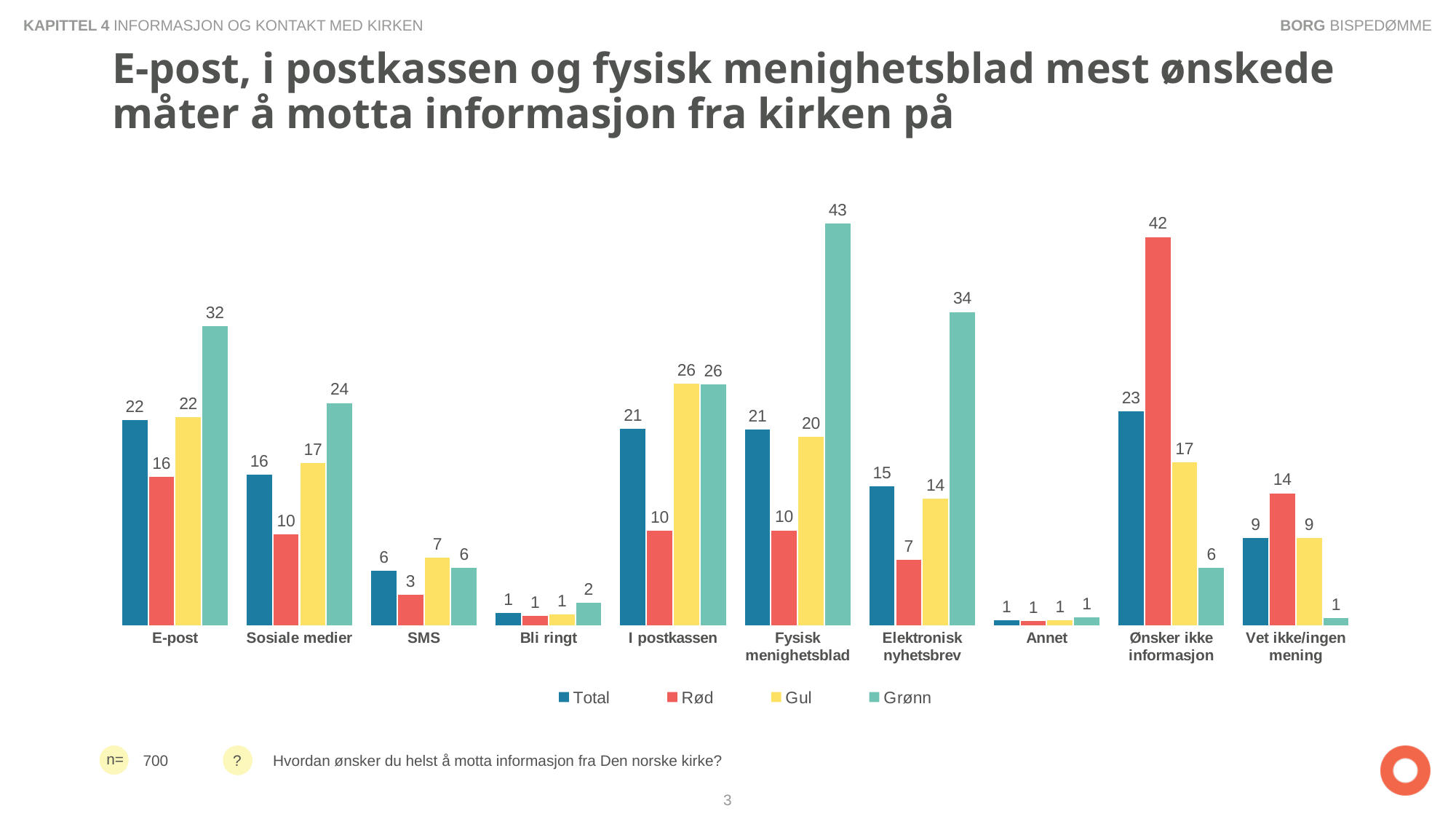
What is the Total value for E-post? 22 How many categories are shown on the x axis? 10 Which category has the highest Total value? Ønsker ikke informasjon Which is larger for Sosiale medier: the Gul value or the Rød value? Gul What is the Grønn value for Fysisk menighetsblad? 43 What is the Rød value for Ønsker ikke informasjon? 42 What is the difference between the Grønn and Rød values for Fysisk menighetsblad? 33 What is the sample size (n=) shown on the slide? 700 How many series does the legend list? 4 Which category has the lowest Grønn value? Annet and Vet ikke/ingen mening (both 1) What kind of chart is shown on the slide? Bar chart What is the Gul value for I postkassen? 26